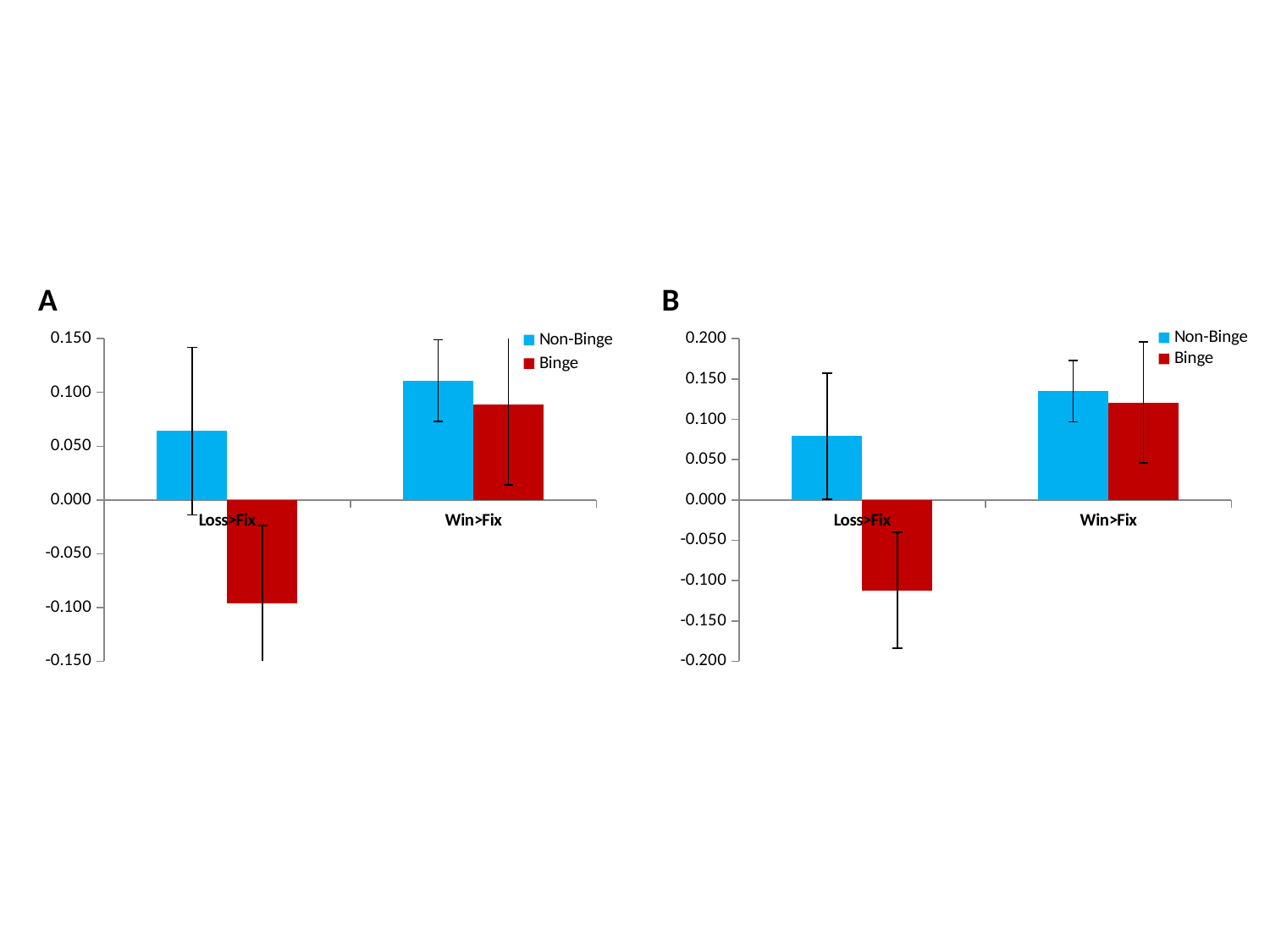
In chart B (the right chart), which series has the larger value for Loss>Fix, Non-Binge or Binge? Non-Binge In chart A (the left chart), is the Non-Binge value for Loss>Fix greater or less than 0.050? greater In chart A (the left chart), which series has the larger value for Win>Fix, Non-Binge or Binge? Non-Binge How many categories are shown on the x axis of chart A (the left chart)? 2 In chart A (the left chart), is the Binge value for Loss>Fix greater or less than -0.050? less In chart B (the right chart), what colour are the Binge bars? red How many series does the legend of chart B (the right chart) list? 2 What kind of chart is chart A (the left chart)? bar chart In chart A (the left chart), which bar has the lowest value? Binge, Loss>Fix In chart B (the right chart), is the Non-Binge value for Win>Fix greater or less than 0.100? greater